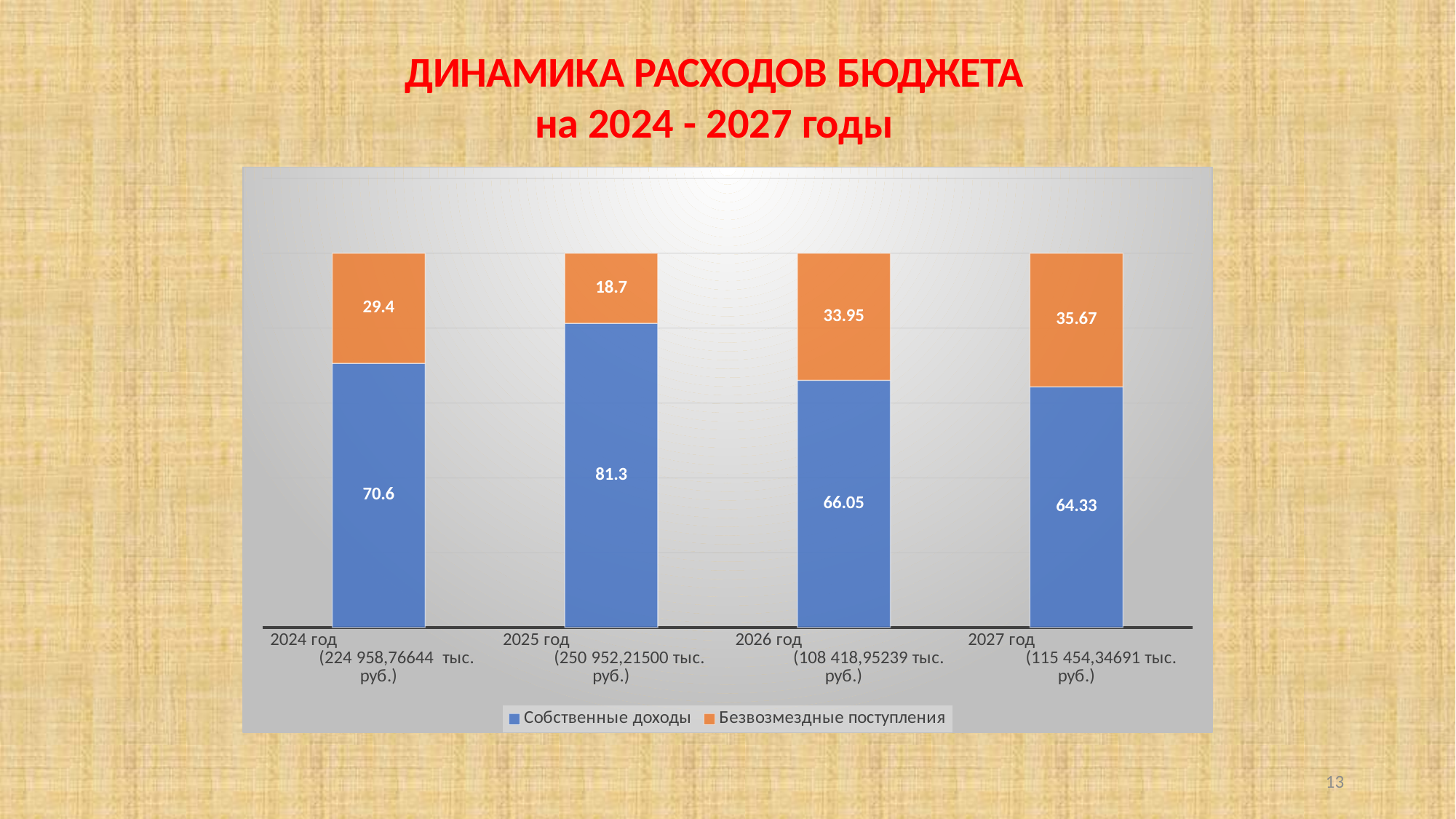
Which is larger in 2027 год: Собственные доходы or Безвозмездные поступления? Собственные доходы Which year has the lowest value for Безвозмездные поступления? 2025 год What is the value of Безвозмездные поступления for 2024 год? 29.4 What is the value of Собственные доходы for 2025 год? 81.3 How many years are shown on the x axis? 4 What is the total of the stacked bar for 2024 год? 100 What is the difference between Собственные доходы and Безвозмездные поступления in 2026 год? 32.1 What is the value of Безвозмездные поступления for 2027 год? 35.67 What kind of chart is shown on the slide? Stacked bar chart Which year has the highest value for Собственные доходы? 2025 год Which colour represents Безвозмездные поступления in the chart? Orange How many series does the legend list? 2